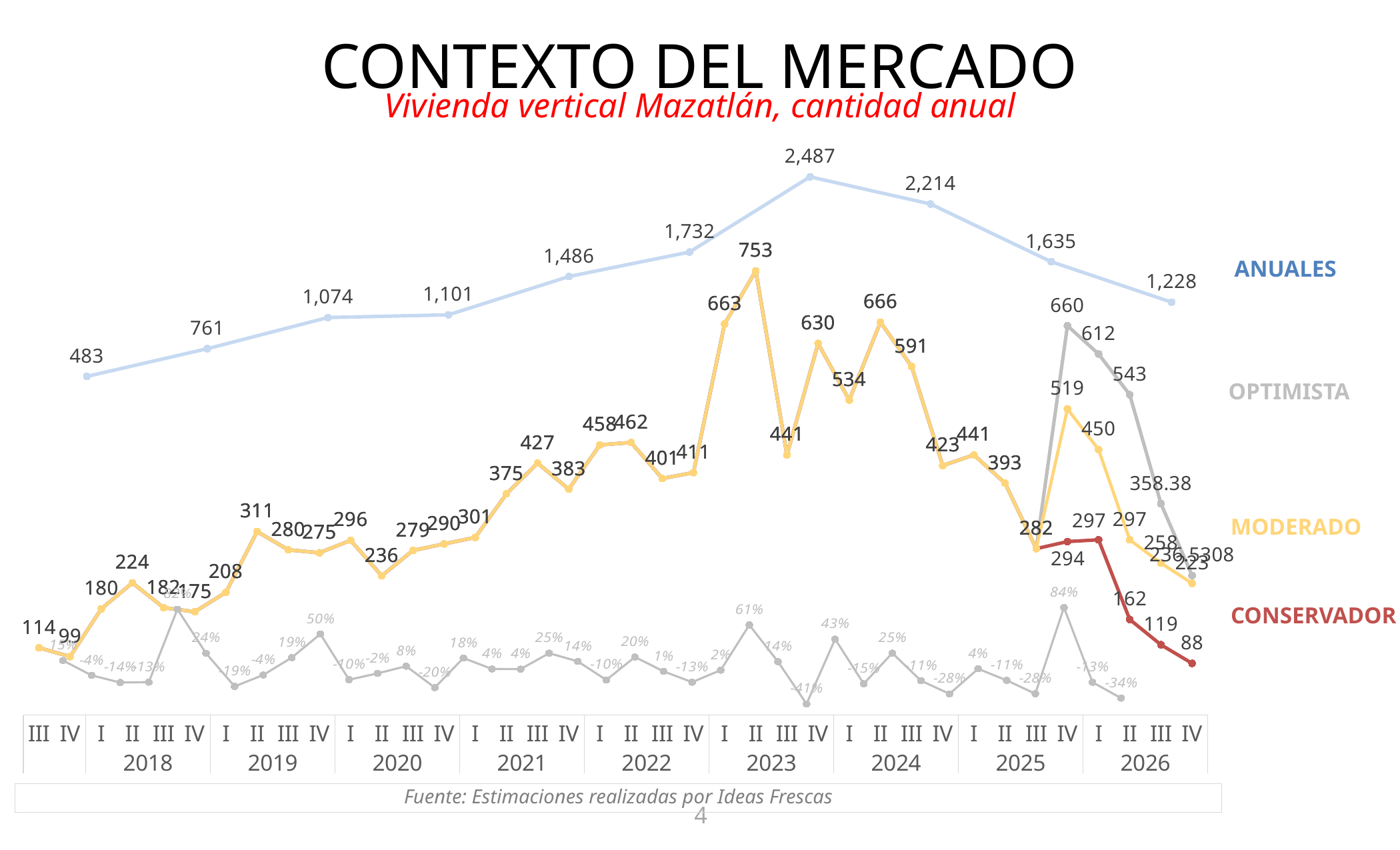
Does the ANUALES line rise or fall from 2023 to 2026? fall What is the quarterly value for 2023 I? 663 How many series are listed in the legend on the right of the chart? 4 What is the lowest value on the ANUALES line? 483 What is the last (2026) value on the ANUALES line? 1,228 How many data points does the ANUALES line have? 10 What is the quarterly value for 2023 II, the highest point on the quarterly line? 753 What is the difference between the highest ANUALES value (2,487) and the next point (2,214)? 273 What is the CONSERVADOR value for 2026 IV? 88 What type of chart is shown on the slide? line chart What is the highest value on the ANUALES line? 2,487